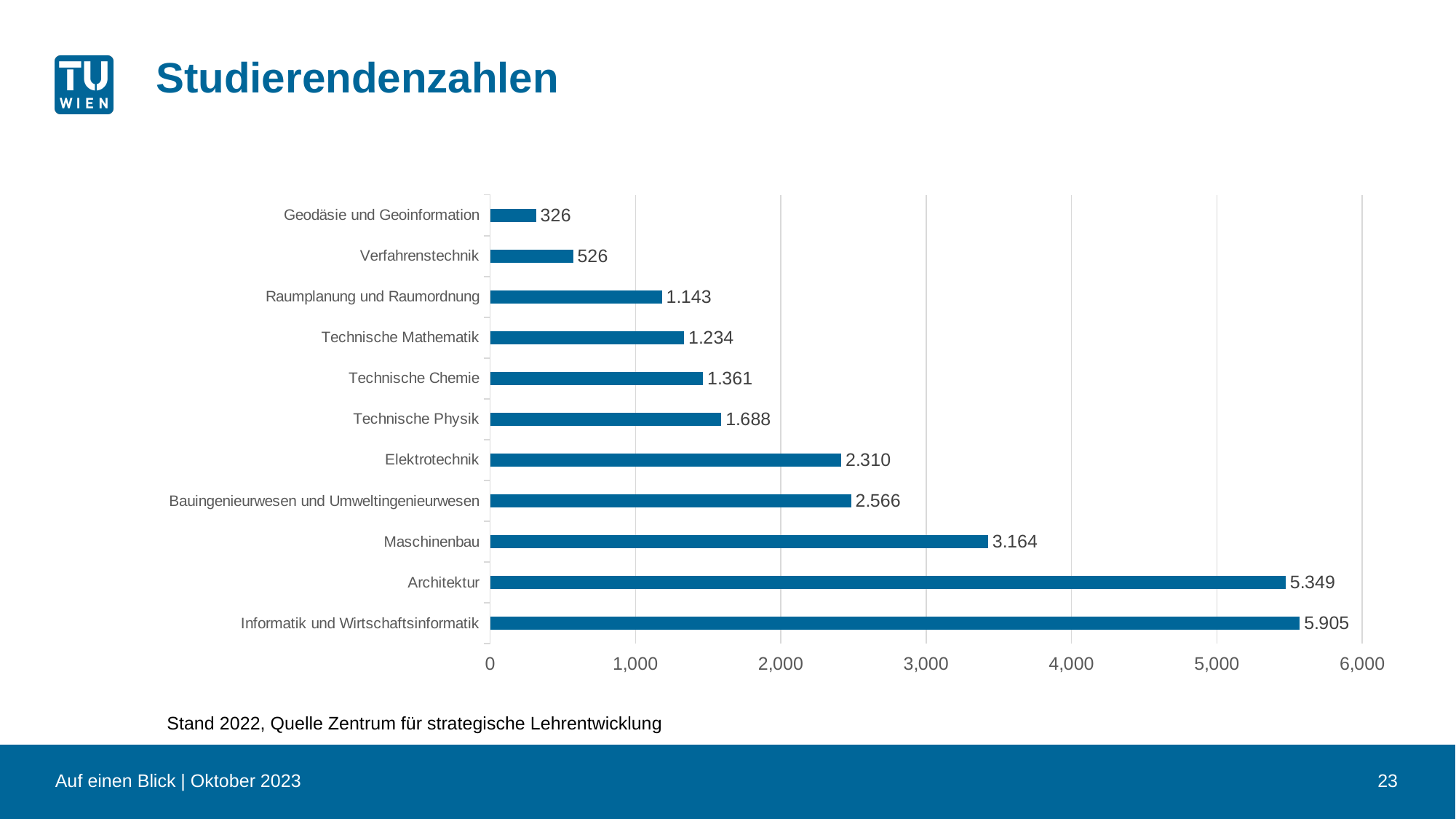
What is the difference between the values for Informatik und Wirtschaftsinformatik and Architektur? 556 How many categories are shown in the chart? 11 Is the value for Bauingenieurwesen und Umweltingenieurwesen greater or less than 2,000? greater What is the value for Geodäsie und Geoinformation? 326 Which is larger, the value for Elektrotechnik or the value for Technische Physik? Elektrotechnik What kind of chart is shown on the slide? bar chart Which category has the highest value? Informatik und Wirtschaftsinformatik What is the value for Technische Chemie? 1.361 Which category has the lowest value? Geodäsie und Geoinformation What is the difference between the values for Maschinenbau and Elektrotechnik? 854 What is the title of the slide containing the chart? Studierendenzahlen What is the value for Maschinenbau? 3.164